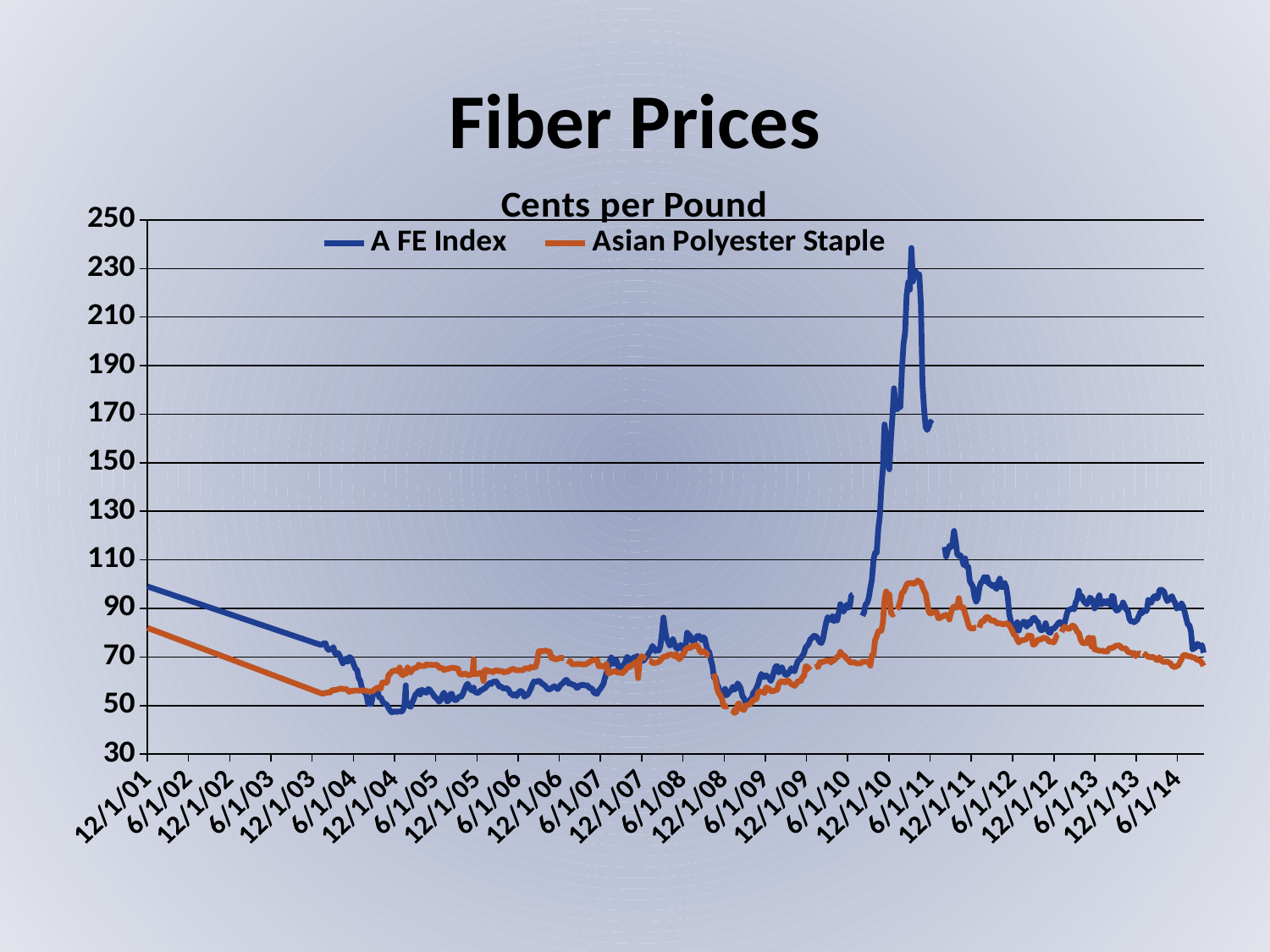
Is the peak value of the A FE Index (around 6/1/11) greater or less than 210? greater Which series is higher at 6/1/11, A FE Index or Asian Polyester Staple? A FE Index What kind of chart is shown on the slide? line chart Between 12/1/01 and 12/1/03, does the A FE Index rise or fall? fall What are the two series named in the legend? A FE Index and Asian Polyester Staple What is the title shown above the chart's plot area? Cents per Pound How many series does the legend list? 2 Which series reaches the highest value anywhere on the chart? A FE Index Is the value of the A FE Index at 12/1/01 greater or less than 90? greater Is the value of the Asian Polyester Staple series at 12/1/03 greater or less than 70? less Which series is higher at 12/1/04, A FE Index or Asian Polyester Staple? Asian Polyester Staple